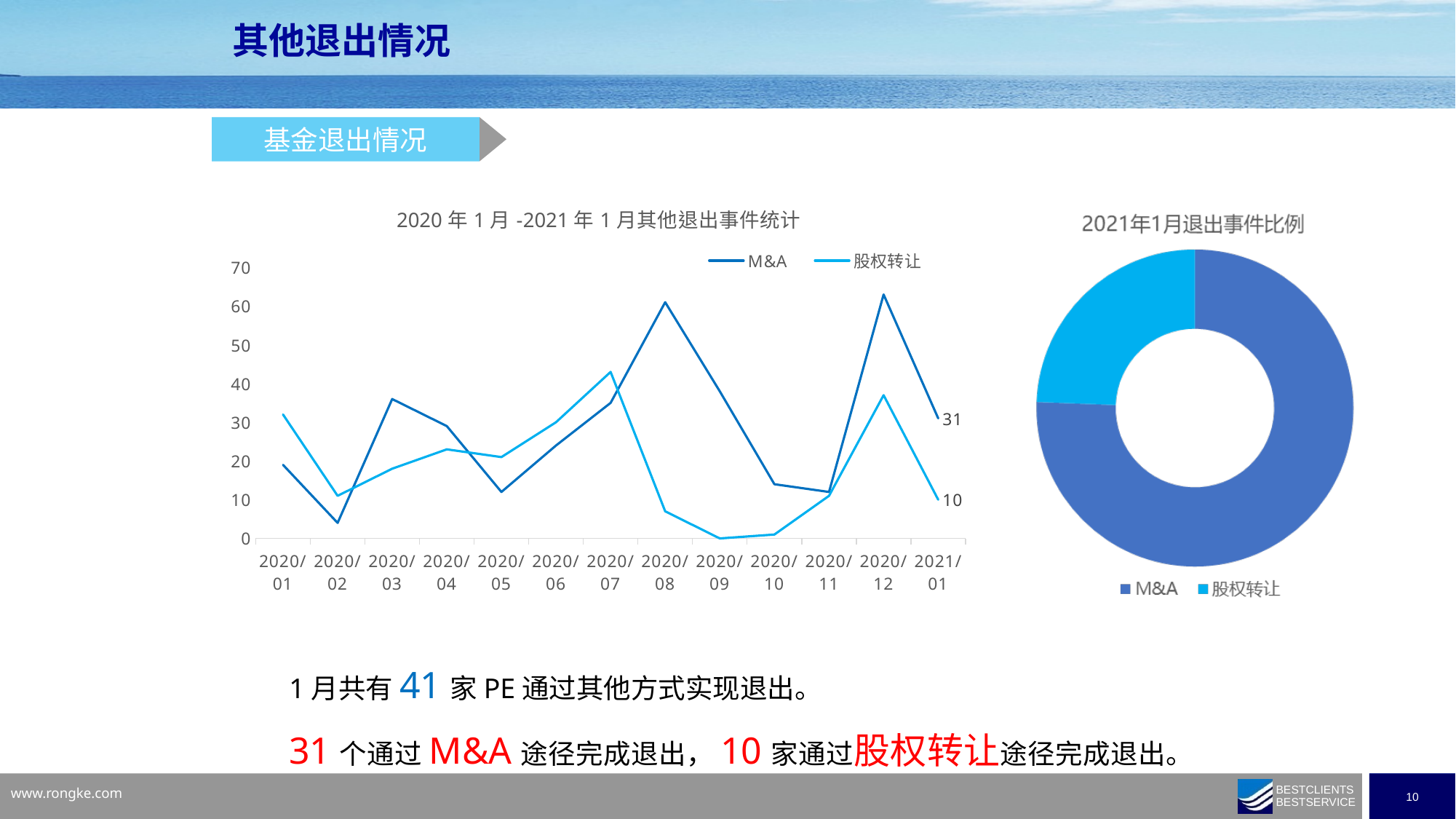
In the line chart titled 2020年1月-2021年1月其他退出事件统计, what is the 股权转让 value for 2021/01? 10 In the line chart titled 2020年1月-2021年1月其他退出事件统计, in which month is the 股权转让 value highest? 2020/07 In the line chart titled 2020年1月-2021年1月其他退出事件统计, how many series does the legend list? 2 In the line chart titled 2020年1月-2021年1月其他退出事件统计, what is the difference between the M&A and 股权转让 values for 2021/01? 21 In the line chart titled 2020年1月-2021年1月其他退出事件统计, which series has the larger value in 2020/01, M&A or 股权转让? 股权转让 In the line chart titled 2020年1月-2021年1月其他退出事件统计, is the 股权转让 value for 2020/09 greater or less than 10? less In the line chart titled 2020年1月-2021年1月其他退出事件统计, is the M&A value for 2020/08 greater or less than 50? greater In the line chart titled 2020年1月-2021年1月其他退出事件统计, how many months are plotted on the x axis? 13 In the line chart titled 2020年1月-2021年1月其他退出事件统计, in which month is the M&A value lowest? 2020/02 What kind of chart is the chart titled 2021年1月退出事件比例 on the right of the slide? Doughnut chart In the line chart titled 2020年1月-2021年1月其他退出事件统计, what is the M&A value for 2021/01? 31 In the line chart titled 2020年1月-2021年1月其他退出事件统计, does the M&A value rise or fall from 2020/12 to 2021/01? fall